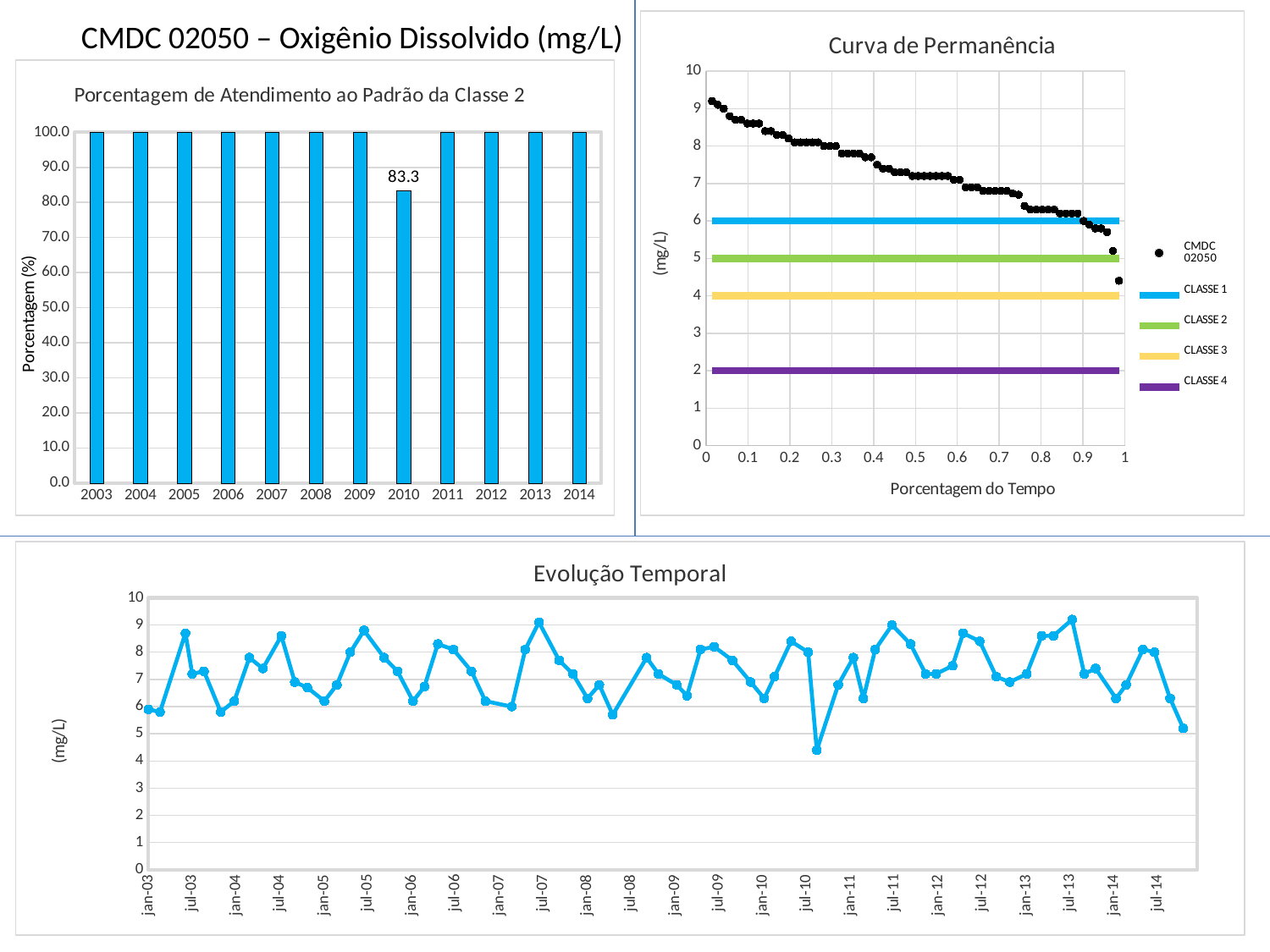
In the chart titled 'Porcentagem de Atendimento ao Padrão da Classe 2', which is larger, the value for 2010 or the value for 2011? 2011 In the chart titled 'Curva de Permanência', what colour is the CLASSE 2 line? green In the chart titled 'Curva de Permanência', at what mg/L value is the CLASSE 4 line drawn? 2 What kind of chart is 'Evolução Temporal'? line chart In the chart titled 'Porcentagem de Atendimento ao Padrão da Classe 2', how many years are shown on the x axis? 12 In the chart titled 'Porcentagem de Atendimento ao Padrão da Classe 2', what is the value for 2005? 100.0 In the chart titled 'Porcentagem de Atendimento ao Padrão da Classe 2', what is the difference between the values for 2009 and 2010? 16.7 In the chart titled 'Porcentagem de Atendimento ao Padrão da Classe 2', which year has the lowest value? 2010 In the chart titled 'Curva de Permanência', how many entries does the legend list? 5 What kind of chart is 'Porcentagem de Atendimento ao Padrão da Classe 2'? bar chart In the chart titled 'Porcentagem de Atendimento ao Padrão da Classe 2', what is the value for 2010? 83.3 In the chart titled 'Curva de Permanência', do the CMDC 02050 points rise or fall as Porcentagem do Tempo increases? fall